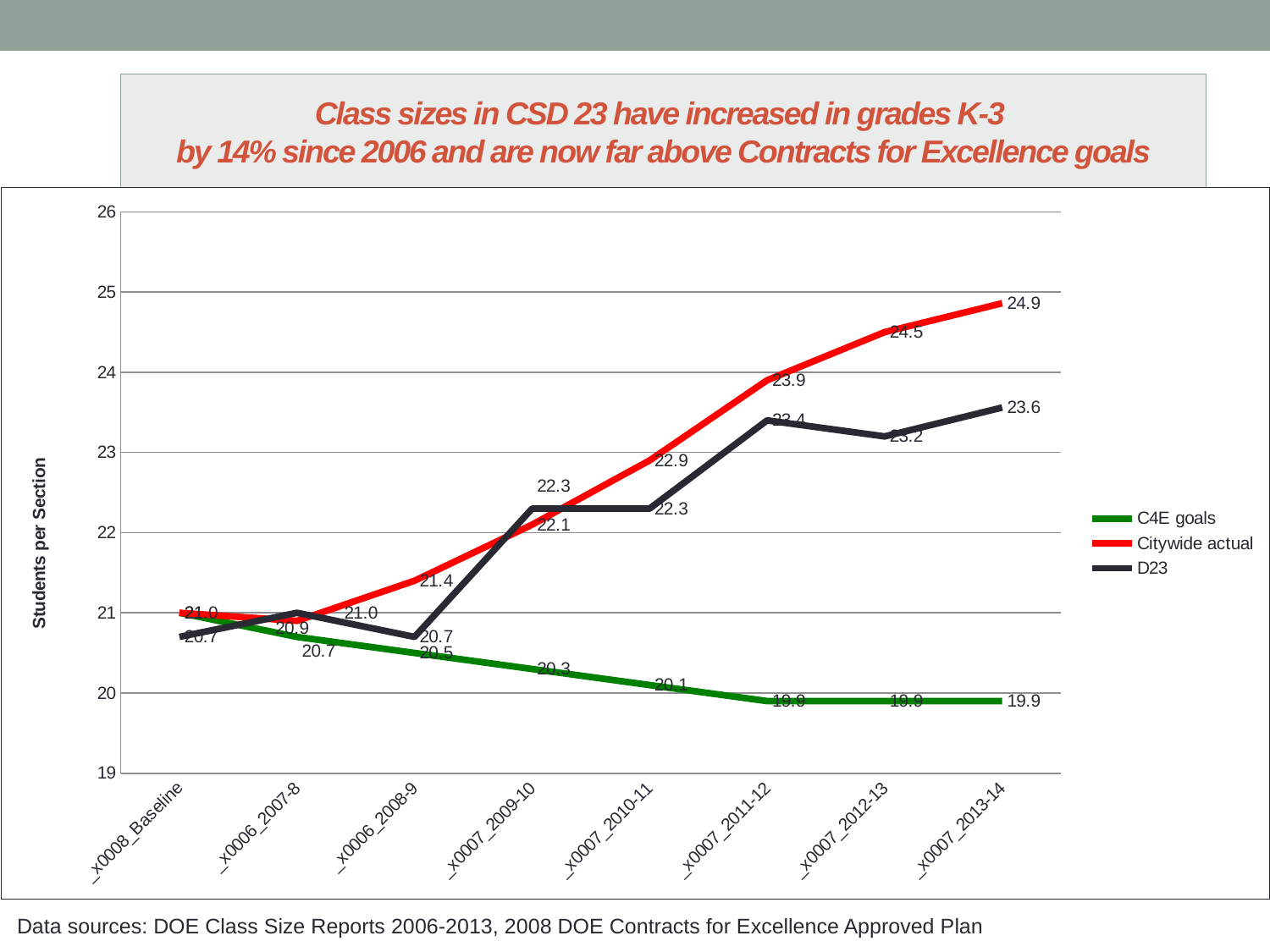
What is the value of Citywide actual for 2011-12? 23.9 What type of chart is shown on the slide? line chart Does the C4E goals series rise or fall from Baseline to 2013-14? fall Which series has the highest value in 2013-14? Citywide actual What is the value of C4E goals for 2013-14? 19.9 How many points are plotted along the x axis for each series? 8 How many series does the legend list? 3 What is the value of D23 for 2013-14? 23.6 Which is larger in 2012-13, Citywide actual or D23? Citywide actual What is the value of Citywide actual for 2013-14? 24.9 What is the difference between D23 and C4E goals in 2013-14? 3.7 What is the difference between Citywide actual and D23 in 2013-14? 1.3